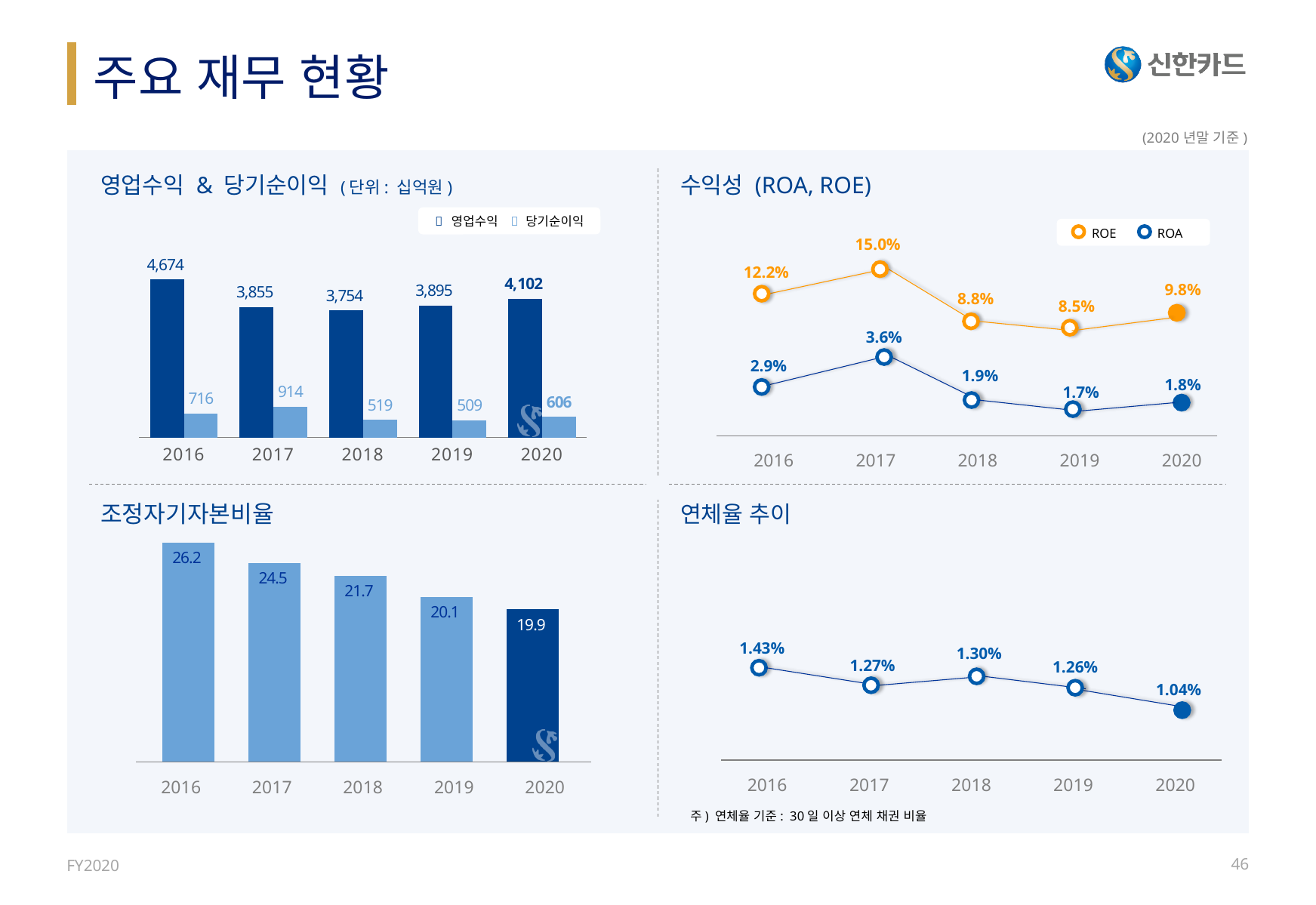
In the 조정자기자본비율 chart (bottom left), what is the value for 2018? 21.7 In the 조정자기자본비율 chart (bottom left), do the values rise or fall from 2016 to 2020? fall In the 영업수익 & 당기순이익 chart (top left), which year has the highest 당기순이익? 2017 In the 수익성 (ROA, ROE) chart (top right), is ROE higher in 2016 or in 2020? 2016 How many series does the legend of the 영업수익 & 당기순이익 chart (top left) list? 2 In the 영업수익 & 당기순이익 chart (top left), what is the 영업수익 value for 2020? 4,102 In the 연체율 추이 chart (bottom right), what is the value for 2020? 1.04% How many data points are plotted in the 연체율 추이 chart (bottom right)? 5 In the 수익성 (ROA, ROE) chart (top right), which year has the lowest ROA? 2019 What kind of chart is the 조정자기자본비율 chart (bottom left)? bar chart In the 수익성 (ROA, ROE) chart (top right), what is the ROE value for 2017? 15.0% In the 영업수익 & 당기순이익 chart (top left), what is the difference between 영업수익 in 2016 and 2017? 819